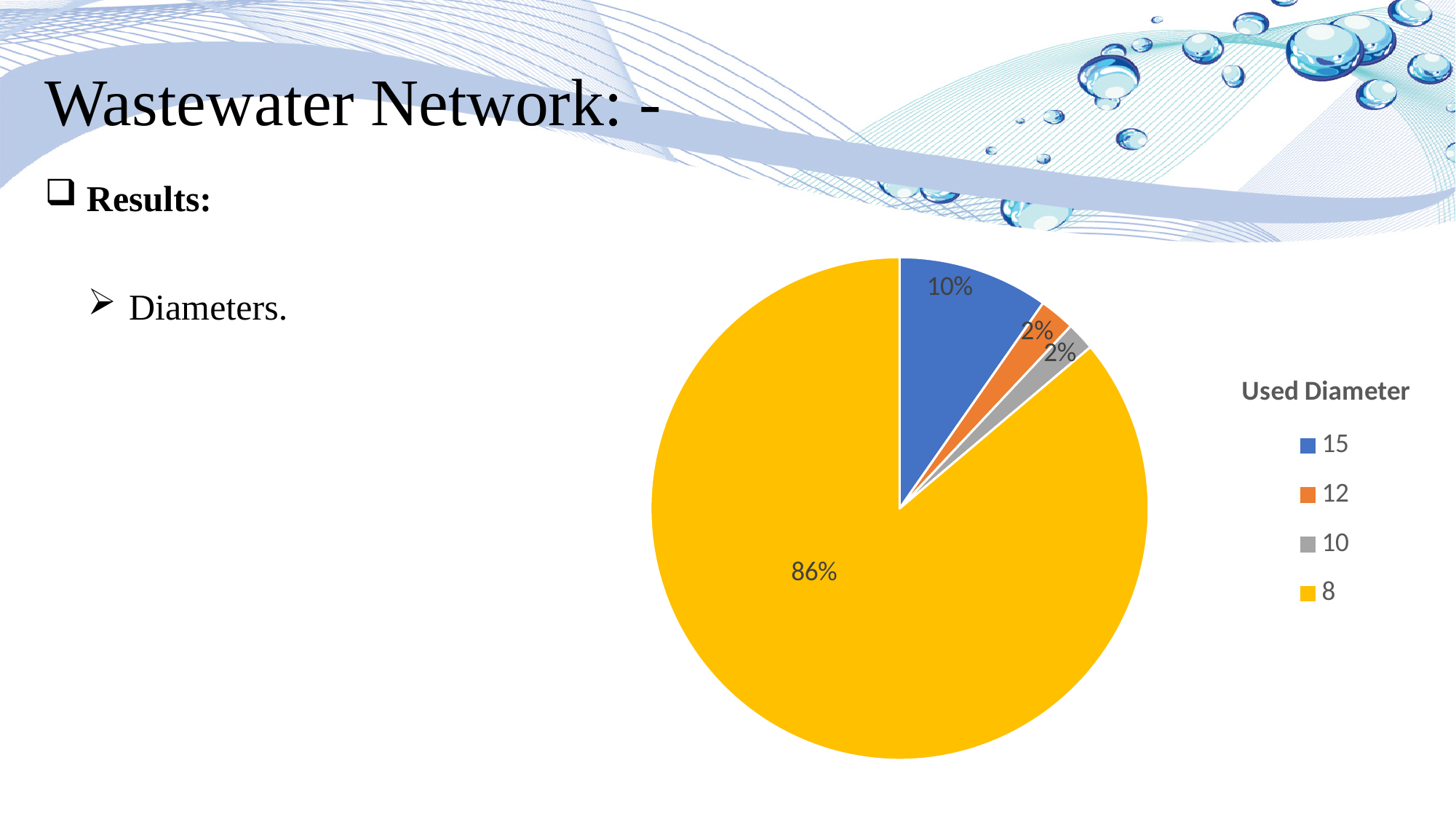
What colour is the slice for diameter 8? yellow Which has a larger share of the pie, diameter 15 or diameter 12? 15 How many entries does the legend list? 4 What share of the pie does diameter 12 take? 2% What share of the pie does diameter 10 take? 2% Which diameter has the largest slice of the pie? 8 What is the difference in percentage points between the share for diameter 8 and the share for diameter 15? 76% What share of the pie does diameter 8 take? 86% What is the title of the legend on the chart? Used Diameter What kind of chart is shown on the slide? pie chart How many slices does the pie chart have? 4